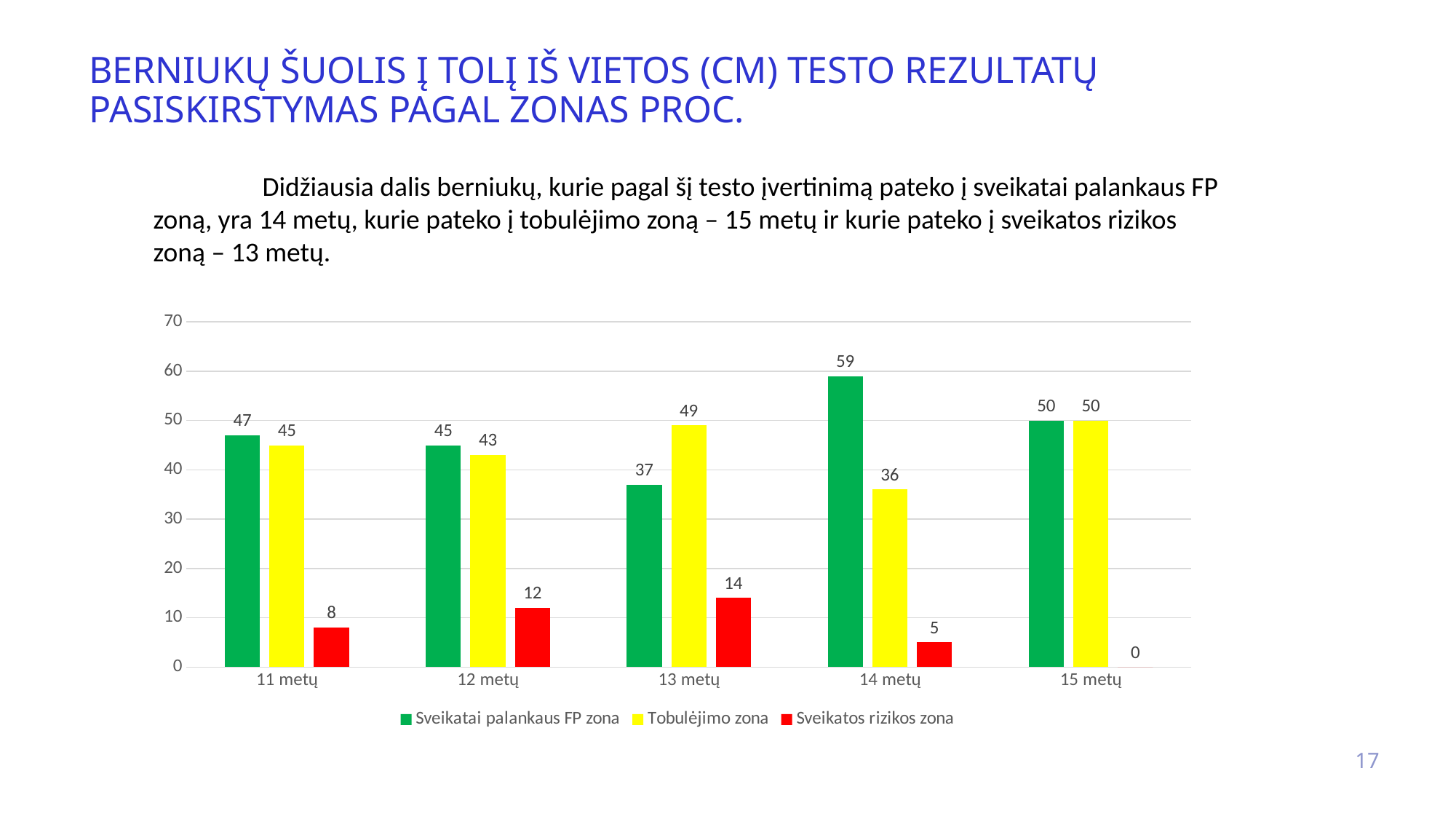
How many series does the legend list? 3 What is the value for Sveikatos rizikos zona at 12 metų? 12 At 13 metų, which is larger: Sveikatai palankaus FP zona or Tobulėjimo zona? Tobulėjimo zona Which age group has the highest value for Sveikatos rizikos zona? 13 metų Which age group has the lowest value for Sveikatos rizikos zona? 15 metų What is the value for Tobulėjimo zona at 13 metų? 49 What is the difference between the Sveikatai palankaus FP zona and Tobulėjimo zona values at 14 metų? 23 What is the value for Sveikatai palankaus FP zona at 14 metų? 59 Which age group has the highest value for Sveikatai palankaus FP zona? 14 metų What kind of chart is shown on the slide? Bar chart How many age groups are shown on the x axis? 5 What colour represents Sveikatos rizikos zona in the chart? Red